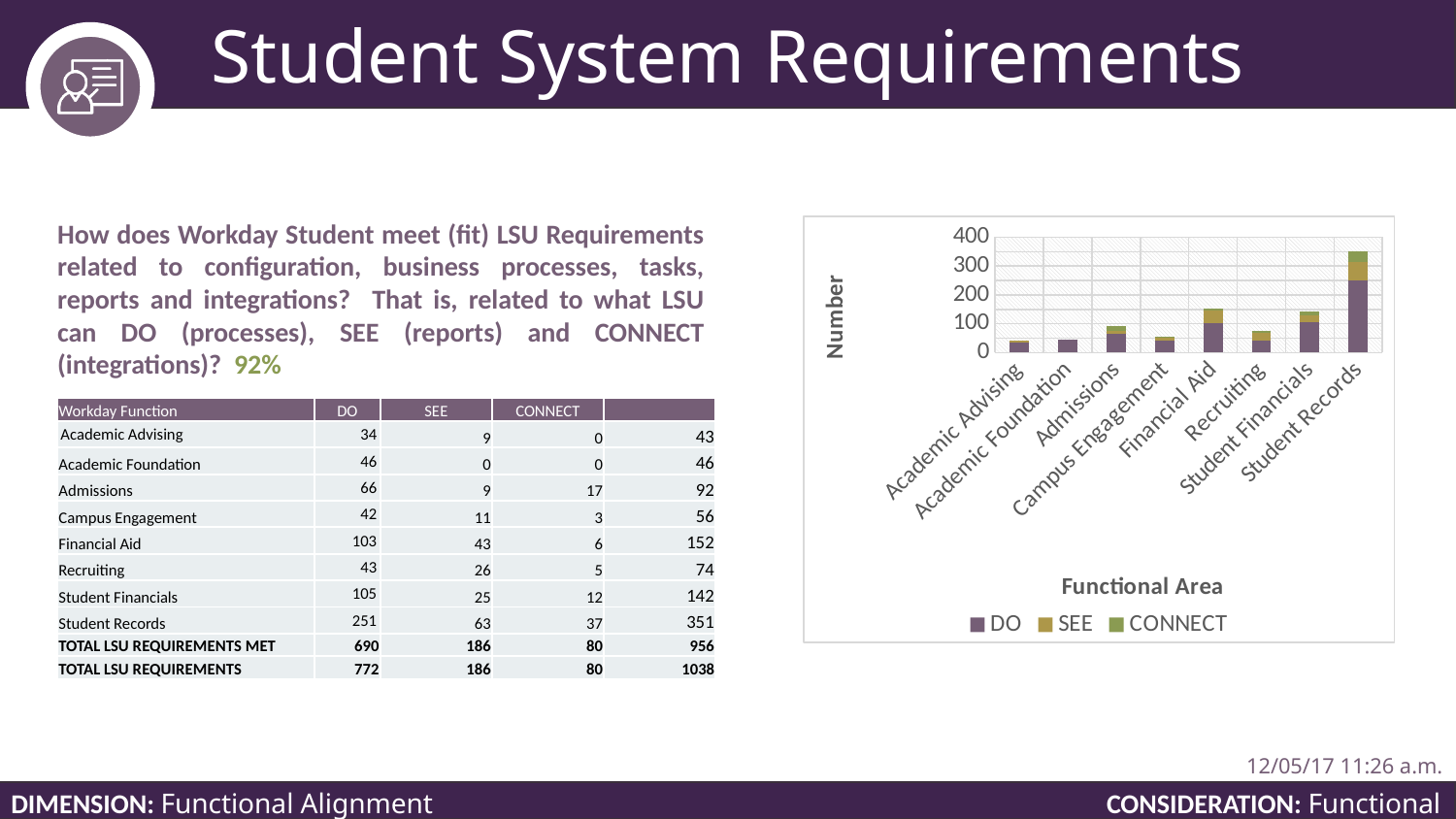
What is the title of the chart's x axis? Functional Area Is the total stacked bar for Recruiting greater or less than 100? less What kind of chart is shown on the slide? bar chart How many functional areas are plotted along the x axis of the chart? 8 Which functional area has the tallest stacked bar in the chart? Student Records Is the total stacked bar for Academic Advising greater or less than 100? less How many series does the chart's legend list? 3 What are the three series named in the chart's legend? DO, SEE, CONNECT Which has the taller stacked bar, Financial Aid or Recruiting? Financial Aid Is the total stacked bar for Student Records greater or less than 300? greater Which has the taller stacked bar, Student Records or Student Financials? Student Records